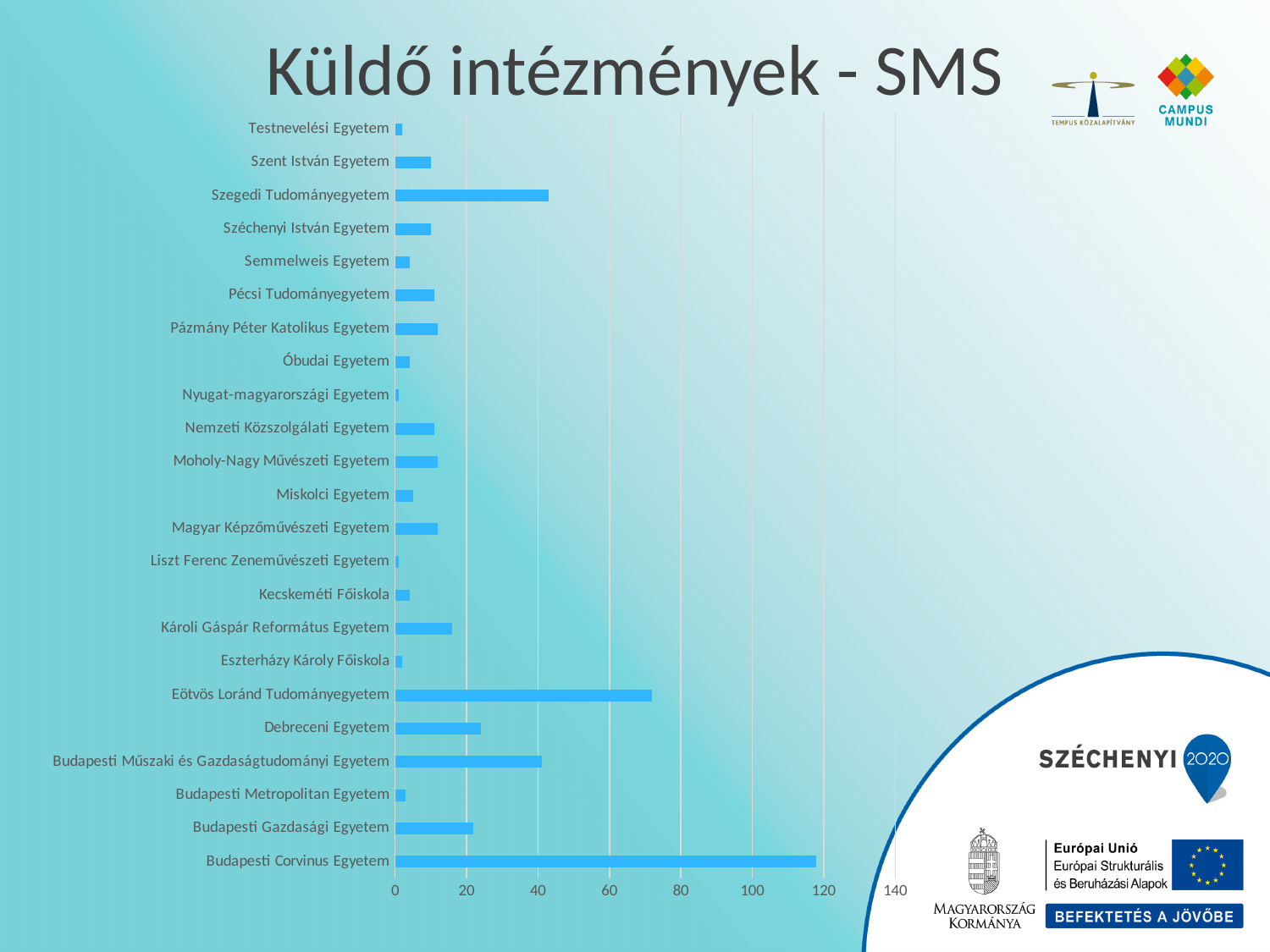
Is the value for Debreceni Egyetem greater or less than 40? less Which has a larger value, Debreceni Egyetem or Károli Gáspár Református Egyetem? Debreceni Egyetem What is the title of the chart? Küldő intézmények - SMS Is the value for Eötvös Loránd Tudományegyetem greater or less than 80? less What is the highest tick value shown on the horizontal axis? 140 Is the value for Szegedi Tudományegyetem greater or less than 20? greater What kind of chart is shown on the slide? bar chart Which has a larger value, Eötvös Loránd Tudományegyetem or Szegedi Tudományegyetem? Eötvös Loránd Tudományegyetem How many institutions (categories) are plotted in the chart? 23 Which institution has the highest value in the chart? Budapesti Corvinus Egyetem